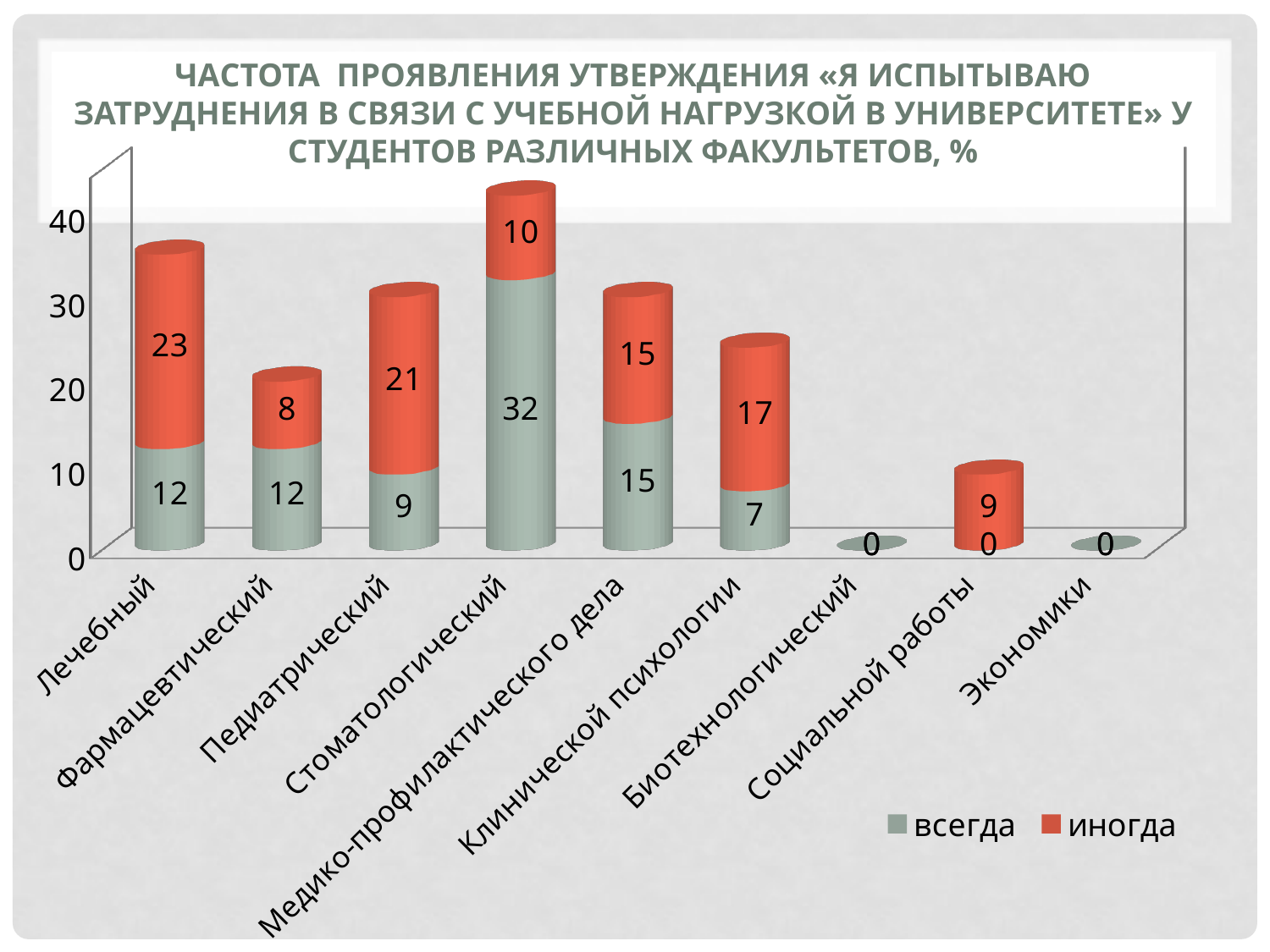
What is the difference between the "иногда" values for Педиатрический and Фармацевтический? 13 Which faculty has the highest value for "всегда"? Стоматологический What type of chart is shown on the slide? Stacked bar chart How many faculties are shown on the x axis? 9 Which is larger: the "всегда" value for Медико-профилактического дела or for Клинической психологии? Медико-профилактического дела What is the value of "всегда" for Стоматологический? 32 What is the total of the stacked bar for Стоматологический? 42 What is the value of "иногда" for Лечебный? 23 How many series does the legend list? 2 Which faculty has the highest value for "иногда"? Лечебный What is the total of the stacked bar for Лечебный? 35 What is the value of "иногда" for Социальной работы? 9